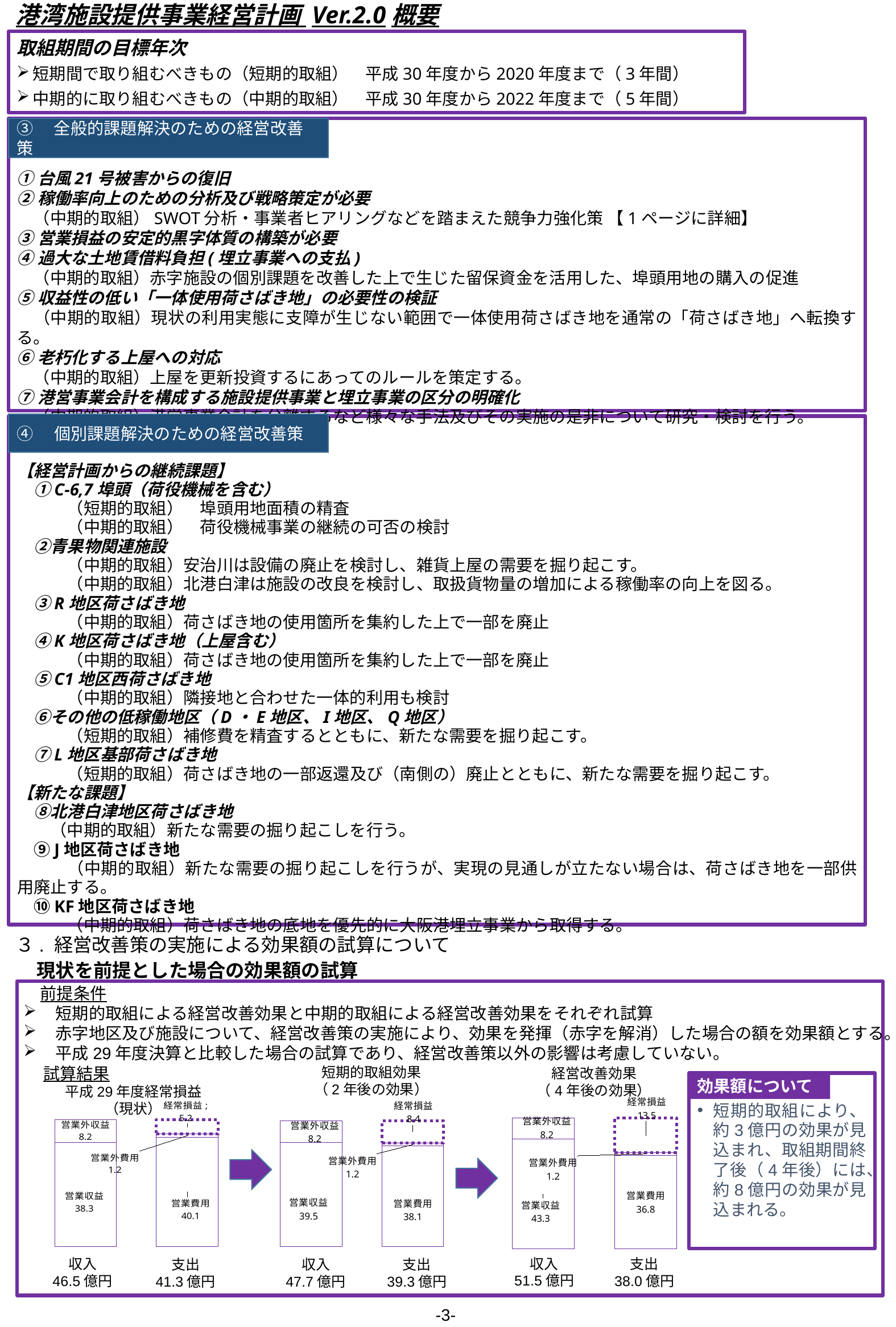
「平成29年度経常損益（現状）」のグラフで、収入の営業収益の値はいくらですか。 38.3 「平成29年度経常損益（現状）」のグラフで、収入の合計はいくらですか。 46.5億円 「経営改善効果（4年後の効果）」のグラフで、経常損益の値はいくらですか。 13.5 「経営改善効果（4年後の効果）」のグラフで、収入の合計と支出の合計の差はいくらですか。 13.5億円 「経営改善効果（4年後の効果）」のグラフで、収入と支出ではどちらの合計が大きいですか。 収入 「短期的取組効果（2年後の効果）」のグラフで、経常損益の値はいくらですか。 8.4 「短期的取組効果（2年後の効果）」のグラフで、支出の合計はいくらですか。 39.3億円 「平成29年度経常損益（現状）」のグラフで、支出の営業費用の値はいくらですか。 40.1 3つのグラフを左から右に見たとき、収入の合計は増加していますか、減少していますか。 増加 「経営改善効果（4年後の効果）」のグラフで、収入の営業収益の値はいくらですか。 43.3 「平成29年度経常損益（現状）」のグラフで、営業外収益と営業外費用ではどちらが大きいですか。 営業外収益 「短期的取組効果（2年後の効果）」のグラフは何種類のグラフですか。 積み上げ棒グラフ